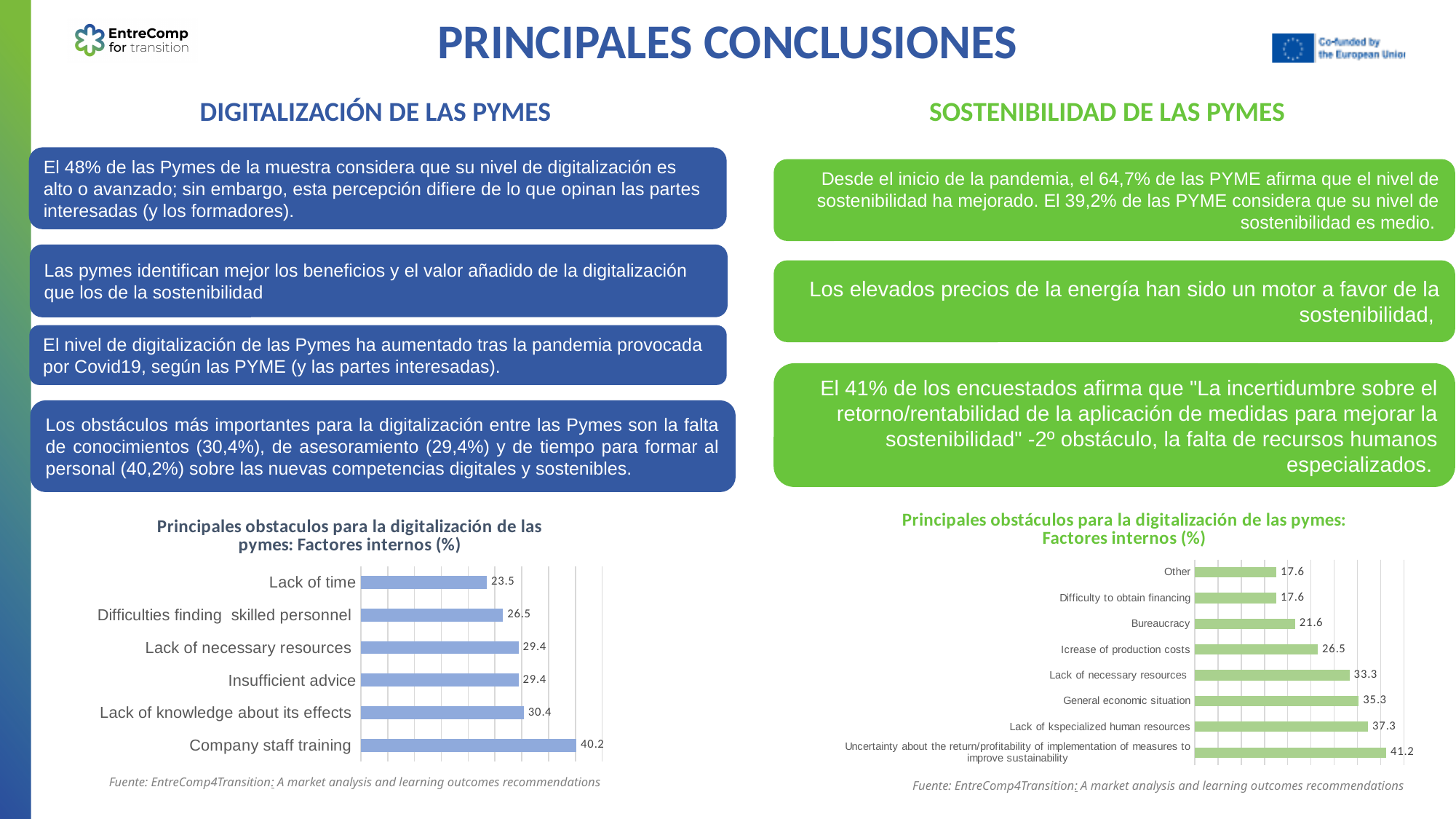
On the right chart, which is larger: Lack of necessary resources or Icrease of production costs? Lack of necessary resources How many categories are shown on the right chart? 8 How many categories are shown on the left chart? 6 On the left chart, which category has the highest value? Company staff training What type of chart is the right chart? Bar chart On the right chart, what is the value for General economic situation? 35.3 On the left chart, what is the difference between Company staff training and Lack of knowledge about its effects? 9.8 On the left chart, which category has the lowest value? Lack of time On the right chart, which category has the highest value? Uncertainty about the return/profitability of implementation of measures to improve sustainability On the right chart, what is the value for Bureaucracy? 21.6 On the left chart, what is the value for Company staff training? 40.2 On the left chart, what is the value for Lack of time? 23.5